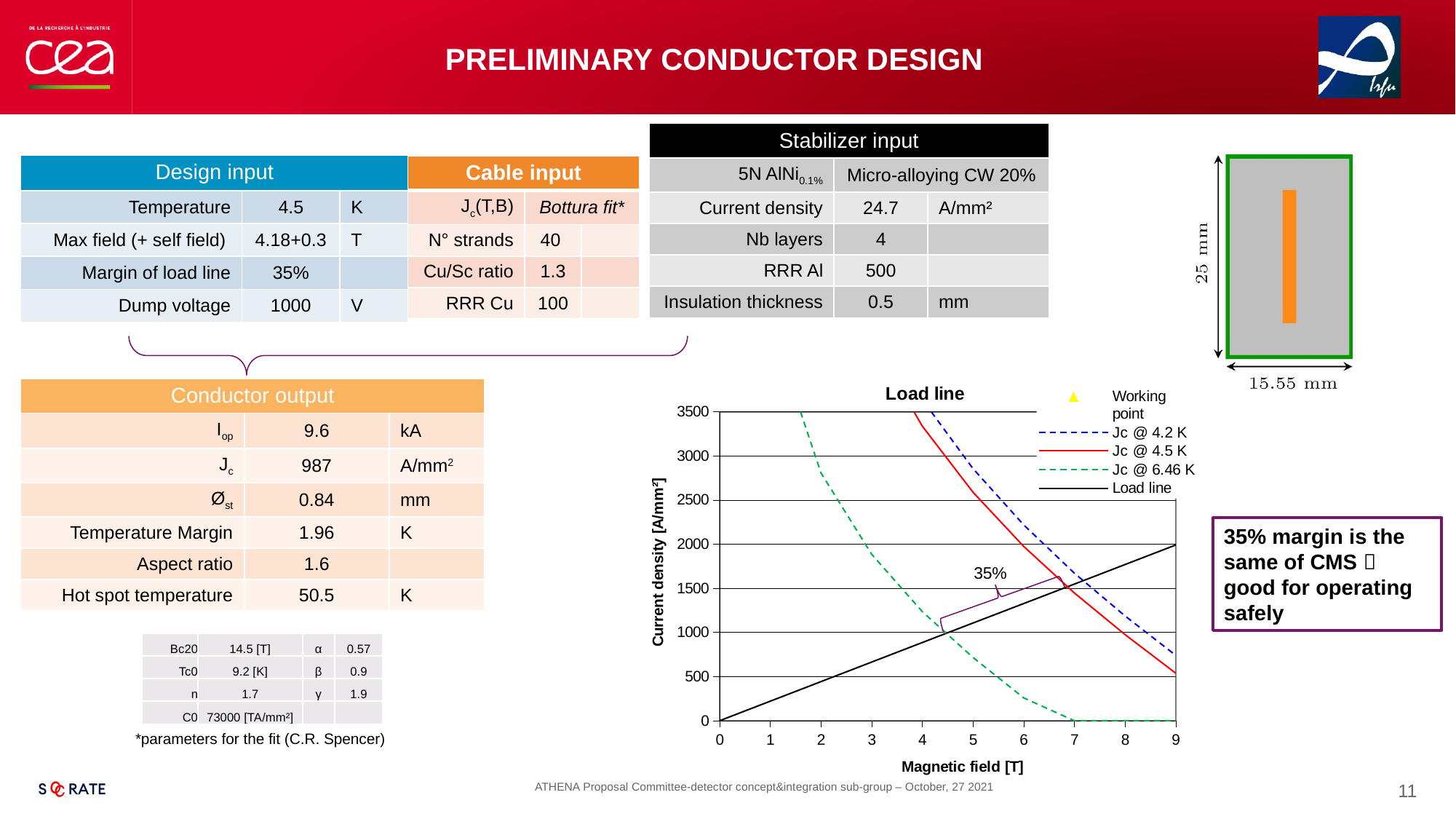
In the "Load line" chart, at 6 T, which series has the higher current density: Jc @ 4.2 K or Jc @ 6.46 K? Jc @ 4.2 K In the "Load line" chart, is the value of Jc @ 6.46 K at 7 T greater or less than 500? less In the "Load line" chart, is the value of Jc @ 4.5 K at 4 T greater or less than 3000? greater What is the label of the y axis of the "Load line" chart? Current density [A/mm²] In the "Load line" chart, is the value of the Load line at 9 T greater or less than 1500? greater In the "Load line" chart, does the Jc @ 4.5 K series rise or fall as the magnetic field increases? fall In the "Load line" chart, does the Load line series rise or fall as the magnetic field increases? rise How many series does the legend of the "Load line" chart list? 5 What kind of chart is the "Load line" chart? line chart What is the title of the chart on the slide? Load line What is the highest value shown on the y axis of the "Load line" chart? 3500